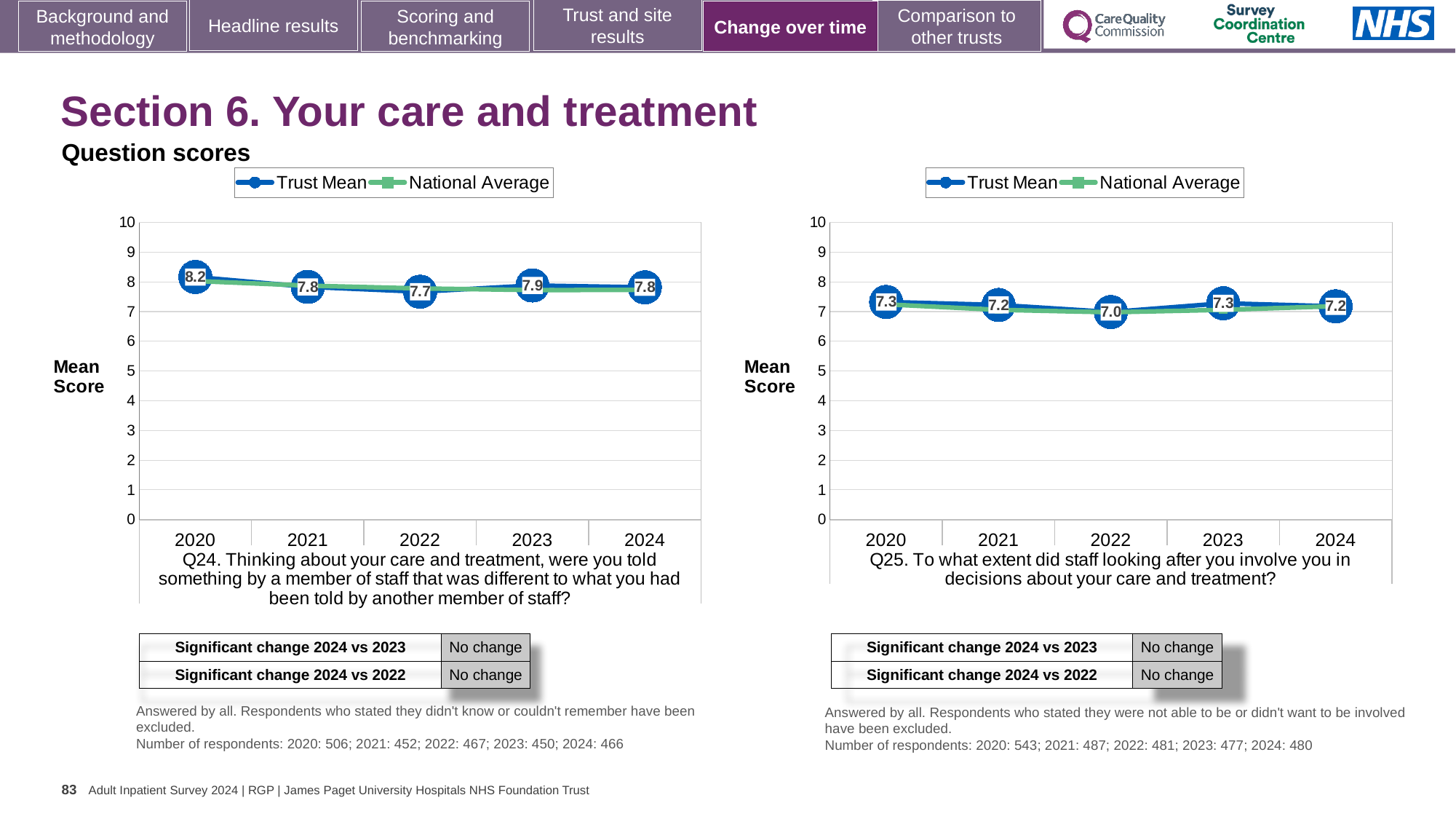
In the Q24 chart on the left, is the Trust Mean score higher in 2023 or in 2024? 2023 In the Q24 chart on the left, which year has the highest Trust Mean score? 2020 In the Q24 chart on the left, what is the difference between the Trust Mean scores for 2020 and 2022? 0.5 In the Q25 chart on the right, which year has the lowest Trust Mean score? 2022 In the Q24 chart on the left, what is the Trust Mean score for 2020? 8.2 How many series does the legend of the Q24 chart on the left list? 2 How many years are plotted on the x axis of the Q25 chart on the right? 5 In the Q25 chart on the right, what is the difference between the Trust Mean scores for 2023 and 2022? 0.3 In the Q24 chart on the left, which year has the lowest Trust Mean score? 2022 In the Q25 chart on the right, what is the Trust Mean score for 2022? 7.0 In the Q25 chart on the right, is the National Average value for 2024 greater or less than 5? greater What kind of chart is used for Q24 on the left? Line chart